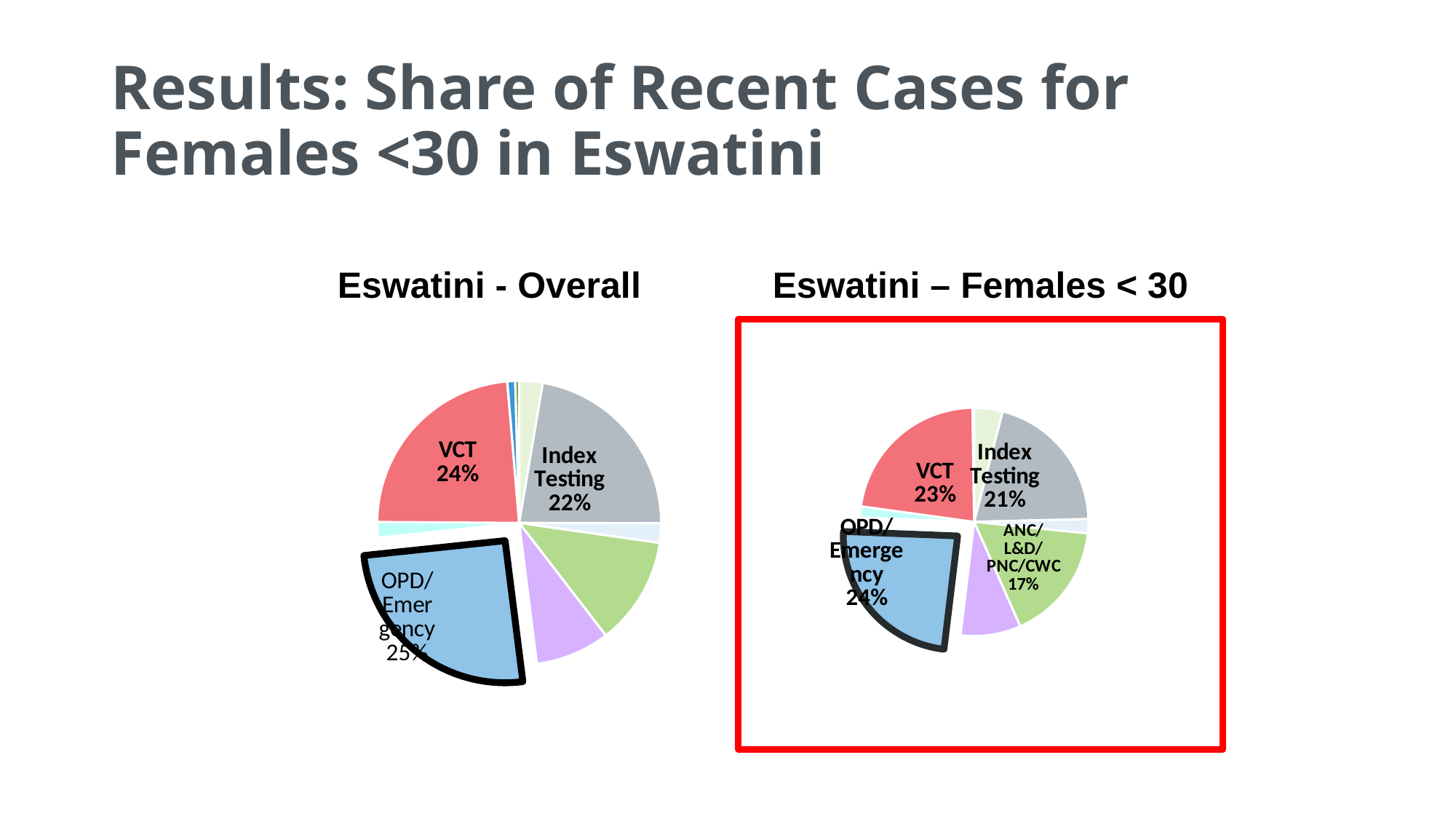
In the Eswatini – Females < 30 pie chart, what share is OPD/Emergency? 24% In the Eswatini – Females < 30 pie chart, what share is ANC/L&D/PNC/CWC? 17% In the Eswatini - Overall pie chart, what share is Index Testing? 22% In the Eswatini – Females < 30 pie chart, what is the difference between the OPD/Emergency share and the ANC/L&D/PNC/CWC share? 7% What is the difference between the VCT share in the Eswatini - Overall chart and the VCT share in the Eswatini – Females < 30 chart? 1% In the Eswatini – Females < 30 pie chart, which is larger, VCT or ANC/L&D/PNC/CWC? VCT In the Eswatini – Females < 30 pie chart, what share is Index Testing? 21% In the Eswatini – Females < 30 pie chart, what share is VCT? 23% Which slice is outlined in black and pulled out in both pie charts? OPD/Emergency In the Eswatini – Females < 30 pie chart, which labelled slice has the smallest share? ANC/L&D/PNC/CWC In the Eswatini - Overall pie chart, what share is VCT? 24% What kind of chart is used for Eswatini - Overall? Pie chart